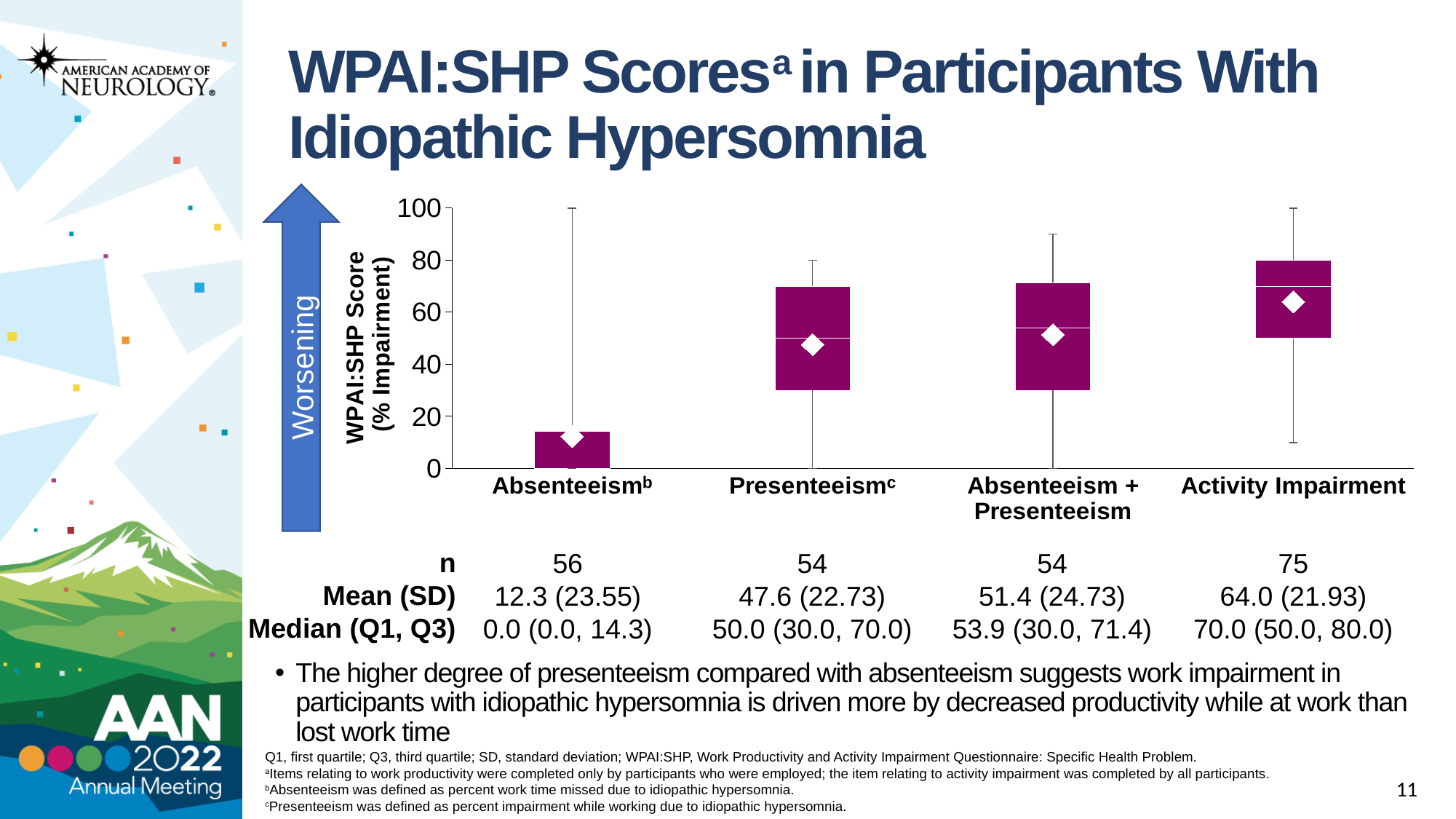
What is the third quartile (Q3) for Absenteeism + Presenteeism? 71.4 Is the median value for Activity Impairment greater or less than 60? greater What is the n for the Activity Impairment category? 75 Do the median WPAI:SHP scores rise or fall from left to right across the categories? Rise What kind of chart is shown on the slide? Box plot What is the median WPAI:SHP score for Presenteeism? 50.0 Which has the larger mean score, Presenteeism or Absenteeism + Presenteeism? Absenteeism + Presenteeism Which category has the highest mean WPAI:SHP score? Activity Impairment What is the difference between the mean score for Activity Impairment and the mean score for Absenteeism? 51.7 How many categories are shown on the x axis of the chart? 4 Which category has the lowest median WPAI:SHP score? Absenteeism What is the mean WPAI:SHP score for Activity Impairment? 64.0